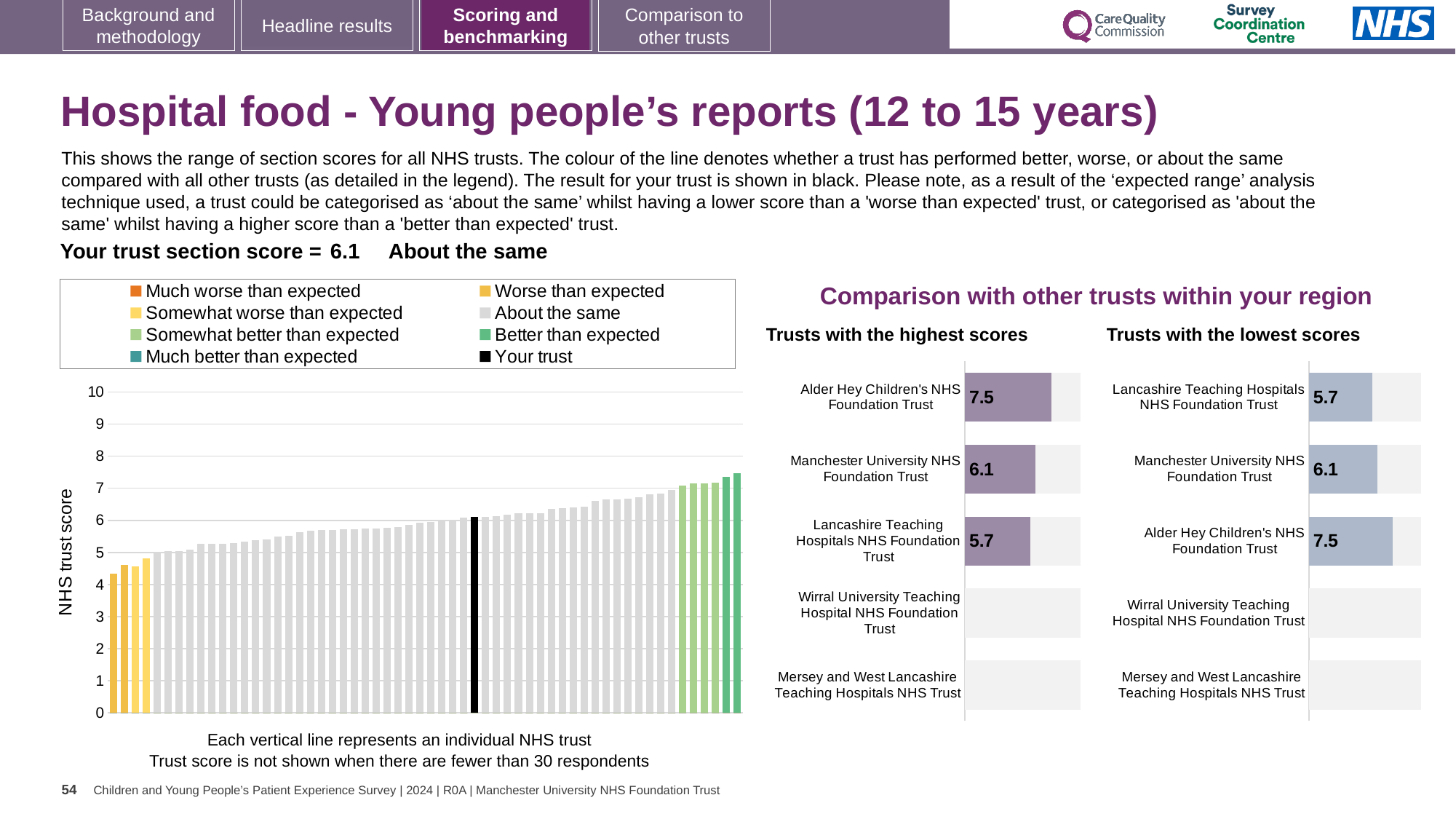
How many categories does the legend above the large 'NHS trust score' chart list? 8 In the large 'NHS trust score' chart, is the value of the leftmost (lowest) bar greater or less than 5? less In the 'Trusts with the highest scores' chart, which trust has the highest score? Alder Hey Children's NHS Foundation Trust In the large 'NHS trust score' chart, do the bar values rise or fall from left to right? rise What type of chart is the large chart on the left with the 'NHS trust score' axis? bar chart In the 'Trusts with the highest scores' chart, what is the difference between the scores of Alder Hey Children's NHS Foundation Trust and Lancashire Teaching Hospitals NHS Foundation Trust? 1.8 How many trusts are listed in the 'Trusts with the highest scores' chart? 5 In the 'Trusts with the lowest scores' chart, which has the larger score: Manchester University NHS Foundation Trust or Alder Hey Children's NHS Foundation Trust? Alder Hey Children's NHS Foundation Trust In the 'Trusts with the lowest scores' chart, which trust with a printed score has the lowest score? Lancashire Teaching Hospitals NHS Foundation Trust In the 'Trusts with the lowest scores' chart, what is the score for Manchester University NHS Foundation Trust? 6.1 In the 'Trusts with the highest scores' chart, what is the score for Lancashire Teaching Hospitals NHS Foundation Trust? 5.7 In the 'Trusts with the highest scores' chart, what is the score for Alder Hey Children's NHS Foundation Trust? 7.5